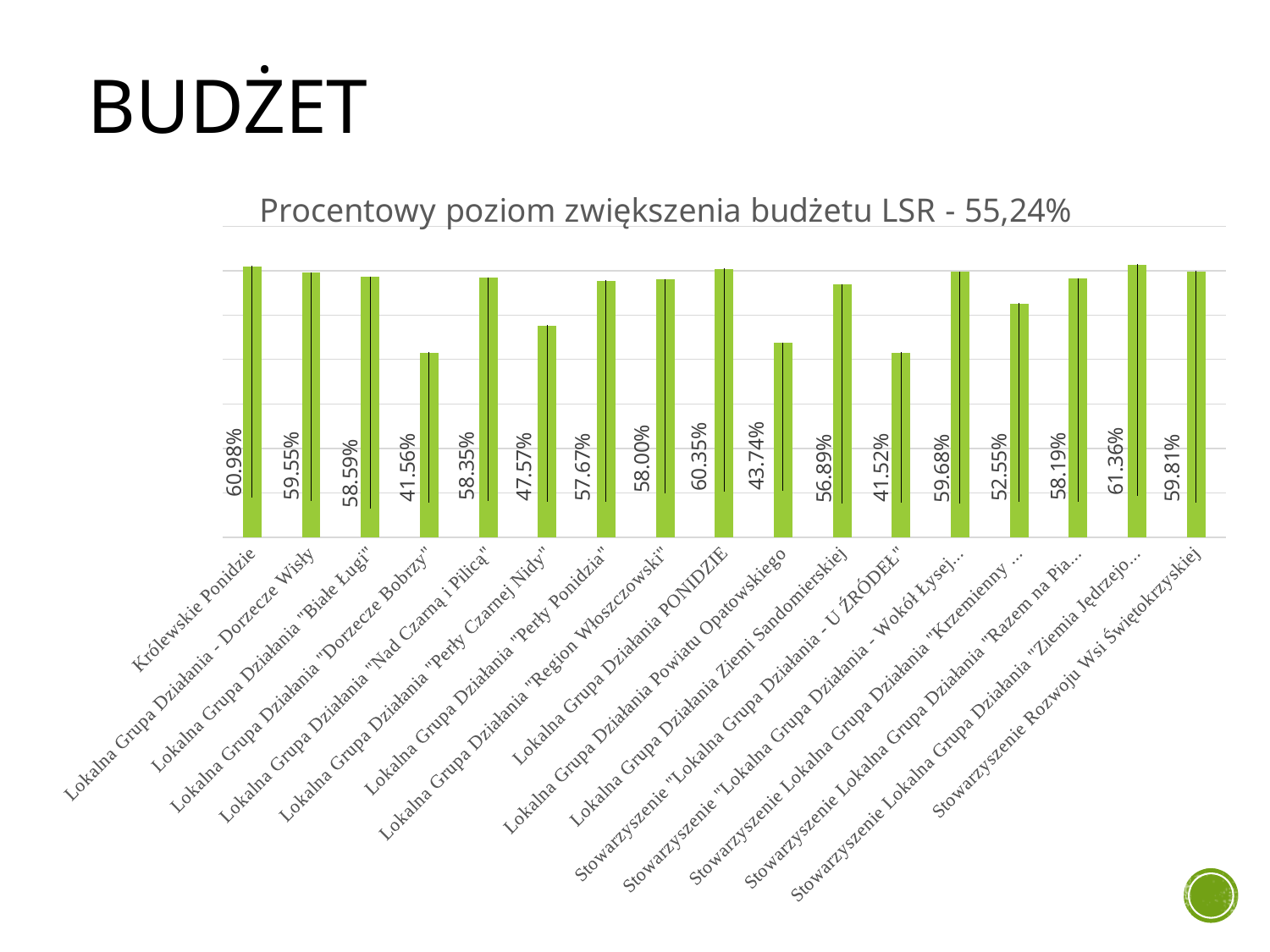
What is the value for Lokalna Grupa Działania "Dorzecze Bobrzy"? 41.56% What is the difference between the values for Królewskie Ponidzie and Lokalna Grupa Działania "Dorzecze Bobrzy"? 19.42% What is the title of the chart? Procentowy poziom zwiększenia budżetu LSR - 55,24% What is the value for Królewskie Ponidzie? 60.98% Which has a larger value: Lokalna Grupa Działania PONIDZIE or Lokalna Grupa Działania Ziemi Sandomierskiej? Lokalna Grupa Działania PONIDZIE What is the highest value shown in the chart? 61.36% What is the value for Stowarzyszenie Rozwoju Wsi Świętokrzyskiej? 59.81% Which has a larger value: Lokalna Grupa Działania "Perły Czarnej Nidy" or Lokalna Grupa Działania "Białe Ługi"? Lokalna Grupa Działania "Białe Ługi" How many categories are shown in the chart? 17 What kind of chart is shown on the slide? Bar chart What is the value for Lokalna Grupa Działania "Perły Czarnej Nidy"? 47.57% What is the value for Lokalna Grupa Działania Powiatu Opatowskiego? 43.74%